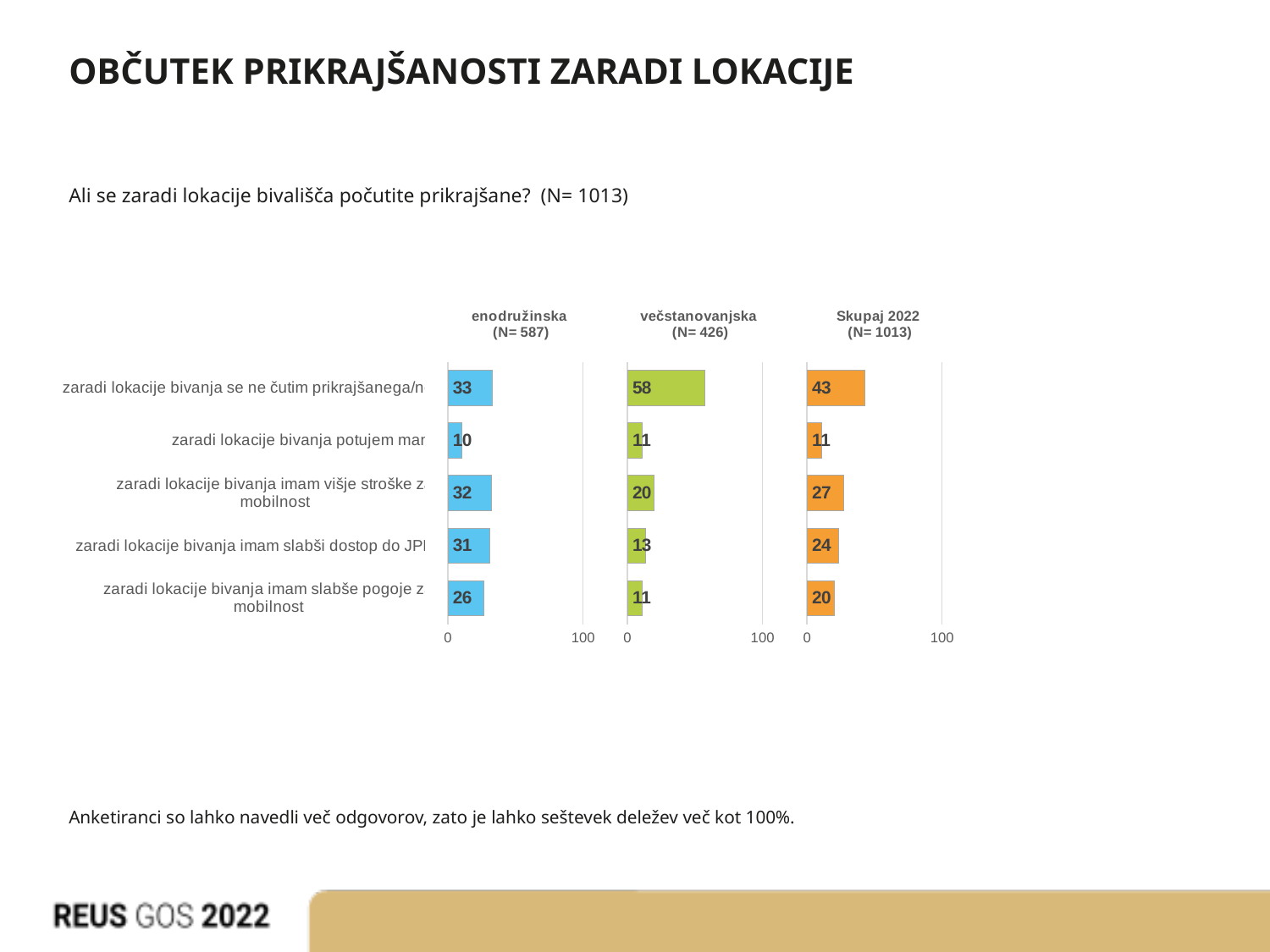
What kind of chart is the enodružinska (N= 587) chart? bar chart In the večstanovanjska (N= 426) chart, which category has the highest value? zaradi lokacije bivanja se ne čutim prikrajšanega In the Skupaj 2022 (N= 1013) chart, what is the value for "zaradi lokacije bivanja imam slabši dostop do JP"? 24 What colour are the bars in the Skupaj 2022 (N= 1013) chart? orange Which is larger: the value for "imam slabši dostop do JP" in the enodružinska chart or in the večstanovanjska chart? enodružinska How many categories are shown in the Skupaj 2022 (N= 1013) chart? 5 In the enodružinska (N= 587) chart, which category has the lowest value? zaradi lokacije bivanja potujem manj In the večstanovanjska (N= 426) chart, what is the value for "zaradi lokacije bivanja imam višje stroške"? 20 In the enodružinska (N= 587) chart, what is the value for "zaradi lokacije bivanja imam slabše pogoje"? 26 In the večstanovanjska (N= 426) chart, is the value for "se ne čutim prikrajšanega" greater or less than 50? greater In the enodružinska (N= 587) chart, what is the value for "zaradi lokacije bivanja se ne čutim prikrajšanega"? 33 In the Skupaj 2022 (N= 1013) chart, what is the difference between the values for "se ne čutim prikrajšanega" and "imam slabše pogoje"? 23